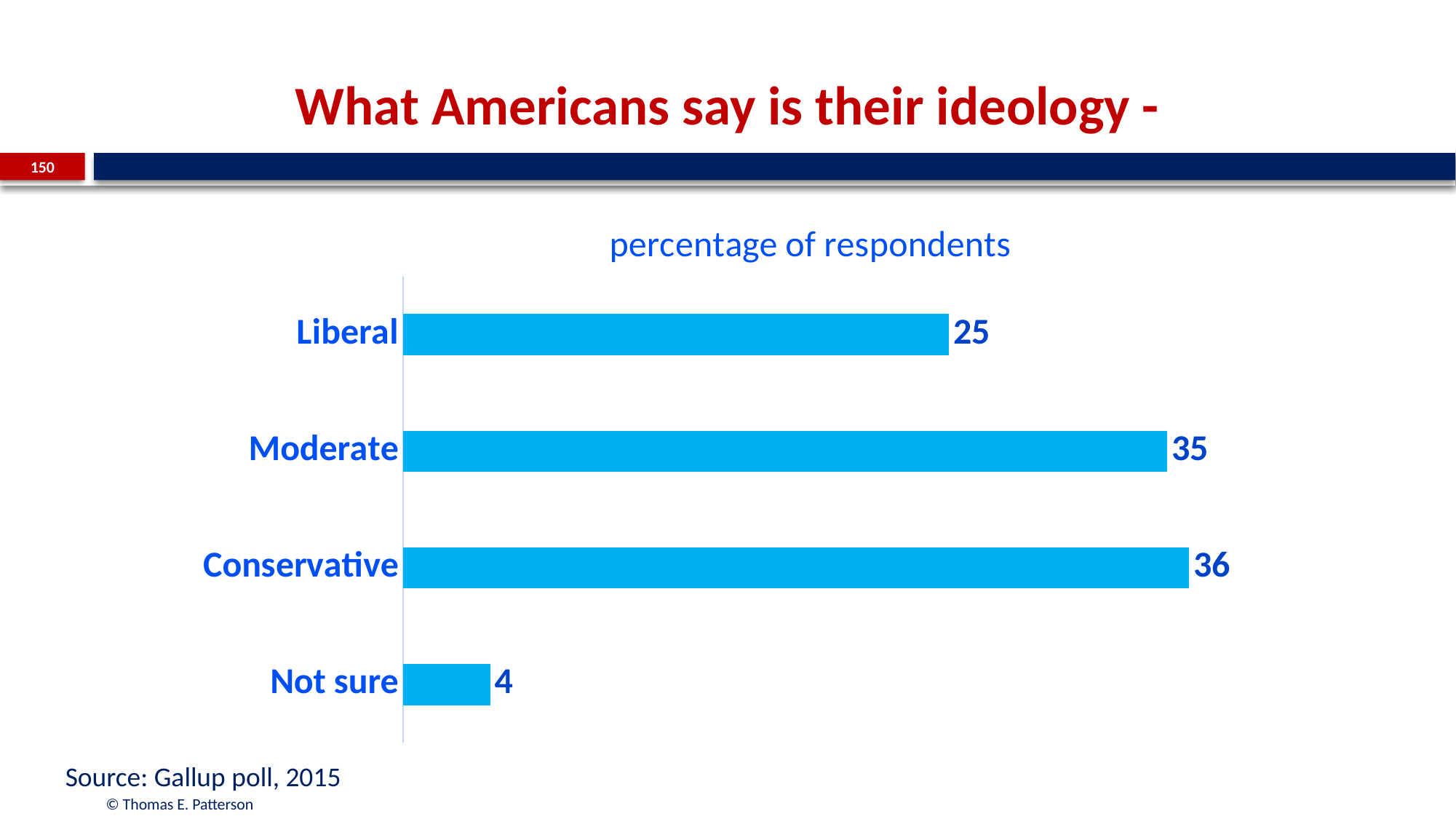
What percentage of respondents say their ideology is Moderate? 35 What kind of chart is shown on the slide? Bar chart Which category has the lowest percentage of respondents? Not sure What is the source of the data shown in the chart? Gallup poll, 2015 What percentage of respondents say their ideology is Liberal? 25 What is the difference between the Moderate and Not sure percentages? 31 Which ideology category has the highest percentage of respondents? Conservative Which has a larger percentage of respondents, Liberal or Moderate? Moderate What is the difference between the Conservative and Liberal percentages? 11 What percentage of respondents are Not sure of their ideology? 4 How many ideology categories are shown in the chart? 4 What percentage of respondents say their ideology is Conservative? 36